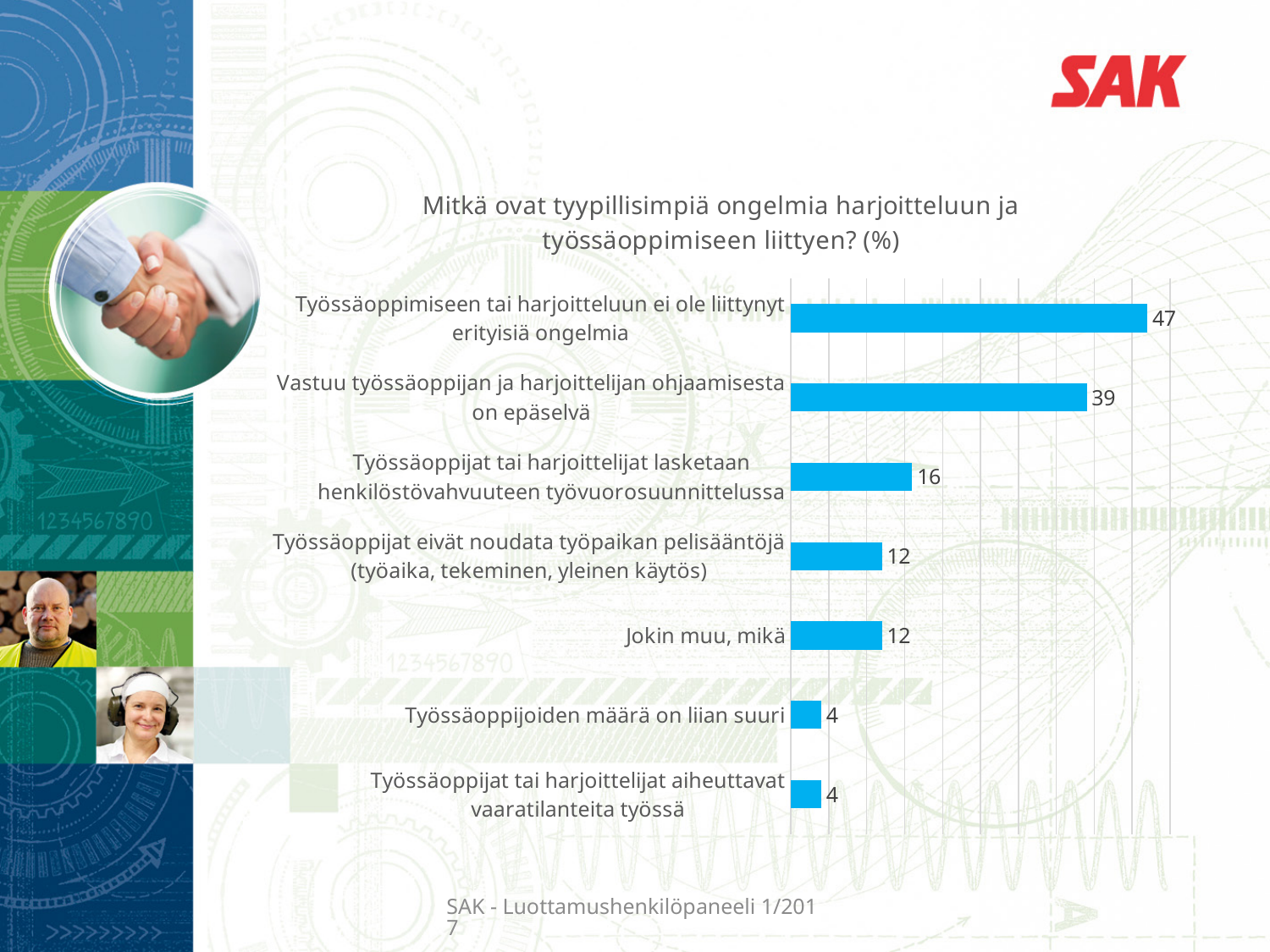
What is the value for "Vastuu työssäoppijan ja harjoittelijan ohjaamisesta on epäselvä"? 39 What is the title of the chart? Mitkä ovat tyypillisimpiä ongelmia harjoitteluun ja työssäoppimiseen liittyen? (%) Which is larger: the value for "Työssäoppijat tai harjoittelijat lasketaan henkilöstövahvuuteen työvuorosuunnittelussa" or the value for "Työssäoppijat eivät noudata työpaikan pelisääntöjä (työaika, tekeminen, yleinen käytös)"? Työssäoppijat tai harjoittelijat lasketaan henkilöstövahvuuteen työvuorosuunnittelussa What is the value for "Jokin muu, mikä"? 12 What kind of chart is shown on the slide? Bar chart How many categories are shown in the chart? 7 What is the difference between the values for "Jokin muu, mikä" and "Työssäoppijoiden määrä on liian suuri"? 8 What is the value for "Työssäoppijoiden määrä on liian suuri"? 4 What is the value for "Työssäoppijat tai harjoittelijat lasketaan henkilöstövahvuuteen työvuorosuunnittelussa"? 16 Which category has the highest value? Työssäoppimiseen tai harjoitteluun ei ole liittynyt erityisiä ongelmia What is the value for "Työssäoppimiseen tai harjoitteluun ei ole liittynyt erityisiä ongelmia"? 47 What is the difference between the values for "Työssäoppimiseen tai harjoitteluun ei ole liittynyt erityisiä ongelmia" and "Vastuu työssäoppijan ja harjoittelijan ohjaamisesta on epäselvä"? 8